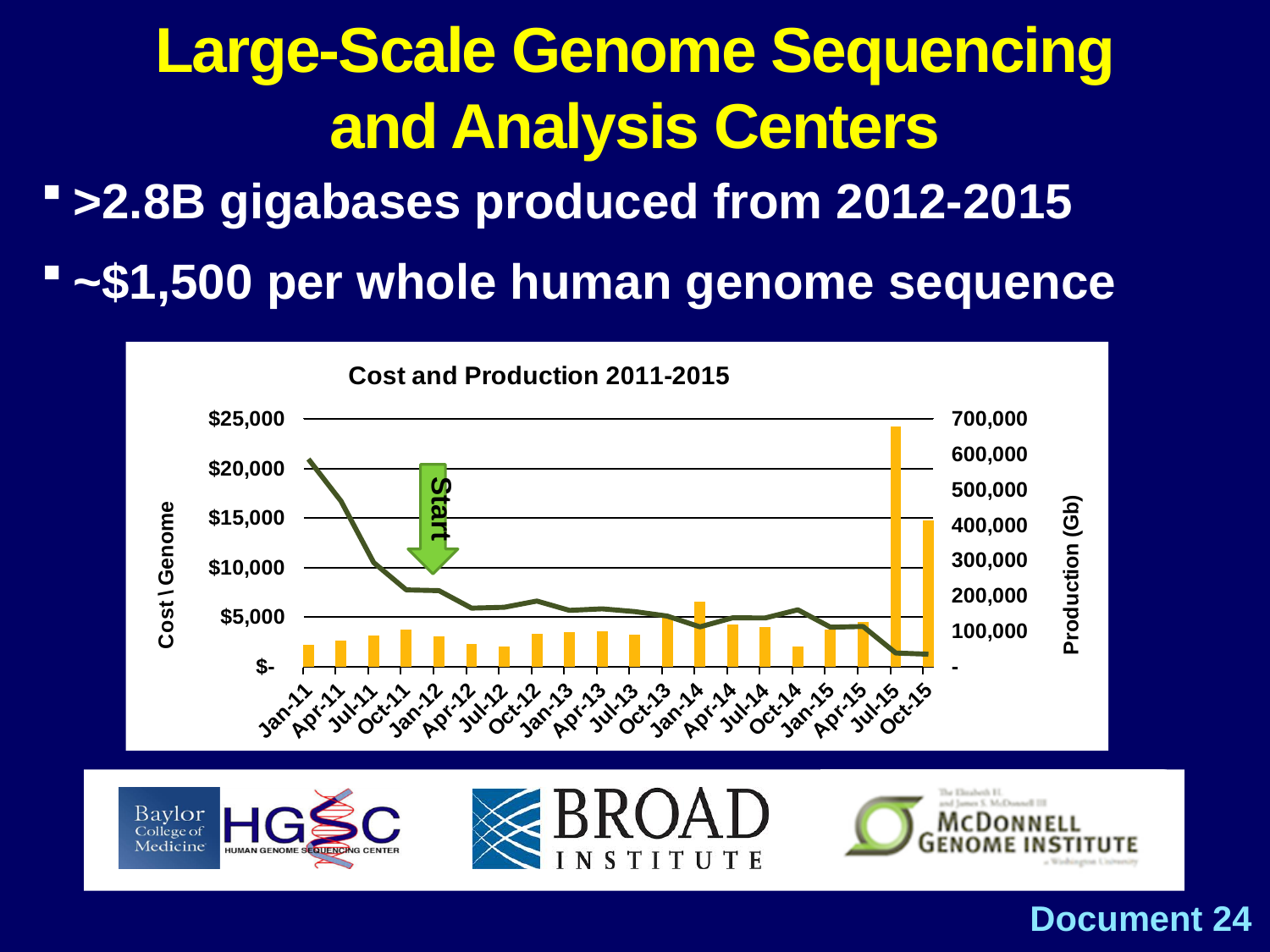
What kind of chart is shown on the slide? A combined line and bar chart Is the production value for Oct-15 greater or less than 300,000? greater What is the title of the chart on the slide? Cost and Production 2011-2015 Is the cost per genome for Oct-15 greater or less than $5,000? less Does the cost per genome line generally rise or fall from Jan-11 to Oct-15? Fall Is the production value for Jan-11 greater or less than 100,000? less Which time point has the highest production bar in the chart? Jul-15 What is the title of the right-hand vertical axis of the chart? Production (Gb) How many time points are labelled along the x axis of the chart? 20 Which has the larger production value, Jul-15 or Oct-15? Jul-15